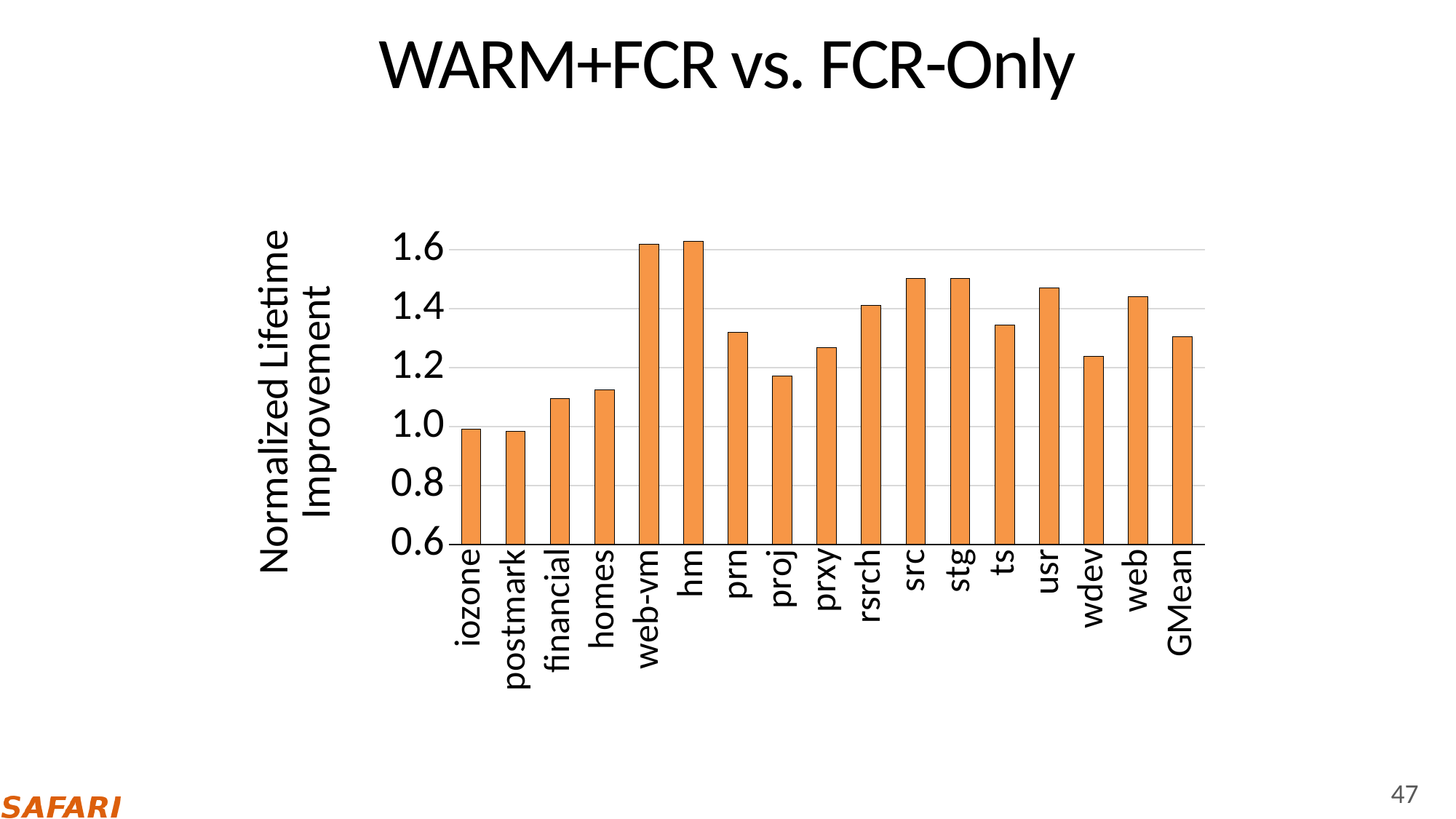
What is the label of the y axis? Normalized Lifetime Improvement Is the value for homes greater or less than 1.2? less What kind of chart is shown on the slide? bar chart Is the value for proj greater or less than 1.2? less Is the value for web-vm greater or less than 1.4? greater Which has the larger value, src or ts? src What is the title of the slide? WARM+FCR vs. FCR-Only Which has the larger value, proj or rsrch? rsrch How many categories are plotted along the x axis? 17 Which has the larger value, usr or wdev? usr